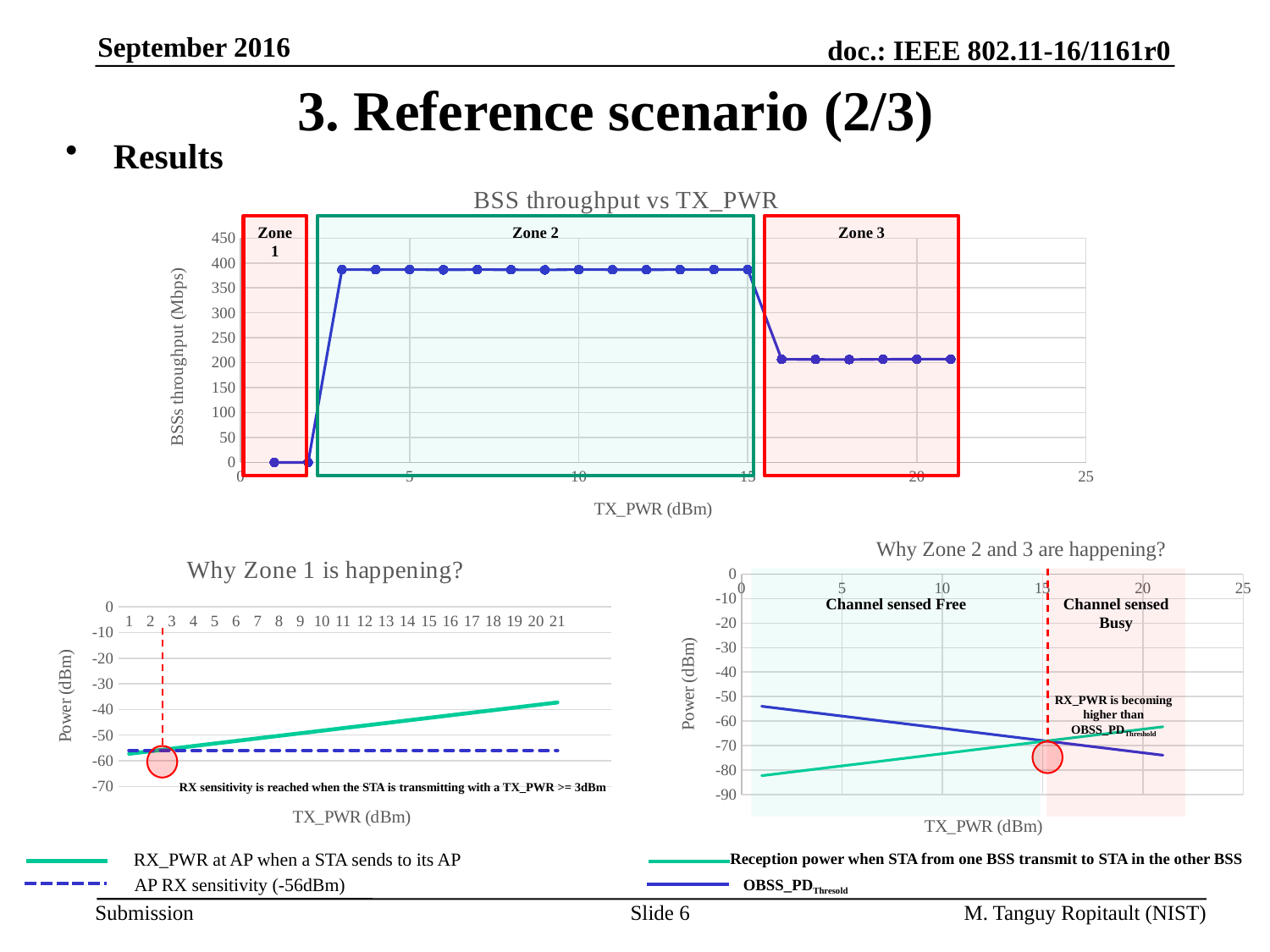
In the 'Why Zone 2 and 3 are happening?' chart, does the OBSS_PD Threshold line rise or fall as TX_PWR increases? fall In the 'BSS throughput vs TX_PWR' chart, is the throughput at TX_PWR 10 dBm greater or less than 350 Mbps? greater How many series does the legend of the 'Why Zone 1 is happening?' chart list? 2 In the 'Why Zone 1 is happening?' chart, does the 'RX_PWR at AP when a STA sends to its AP' line rise or fall as TX_PWR increases? rise How many zones are marked on the 'BSS throughput vs TX_PWR' chart? 3 What kind of chart is the 'BSS throughput vs TX_PWR' chart? line chart In the 'Why Zone 2 and 3 are happening?' chart, is the reception power at TX_PWR 5 dBm greater or less than -70 dBm? less In the 'BSS throughput vs TX_PWR' chart, does the throughput rise or fall when TX_PWR goes from 15 dBm to 16 dBm? fall In the 'BSS throughput vs TX_PWR' chart, is the throughput at TX_PWR 20 dBm greater or less than 250 Mbps? less In the 'BSS throughput vs TX_PWR' chart, which has the higher throughput: TX_PWR 5 dBm or TX_PWR 18 dBm? TX_PWR 5 dBm In the 'Why Zone 1 is happening?' chart, what is the AP RX sensitivity value given in the legend? -56dBm